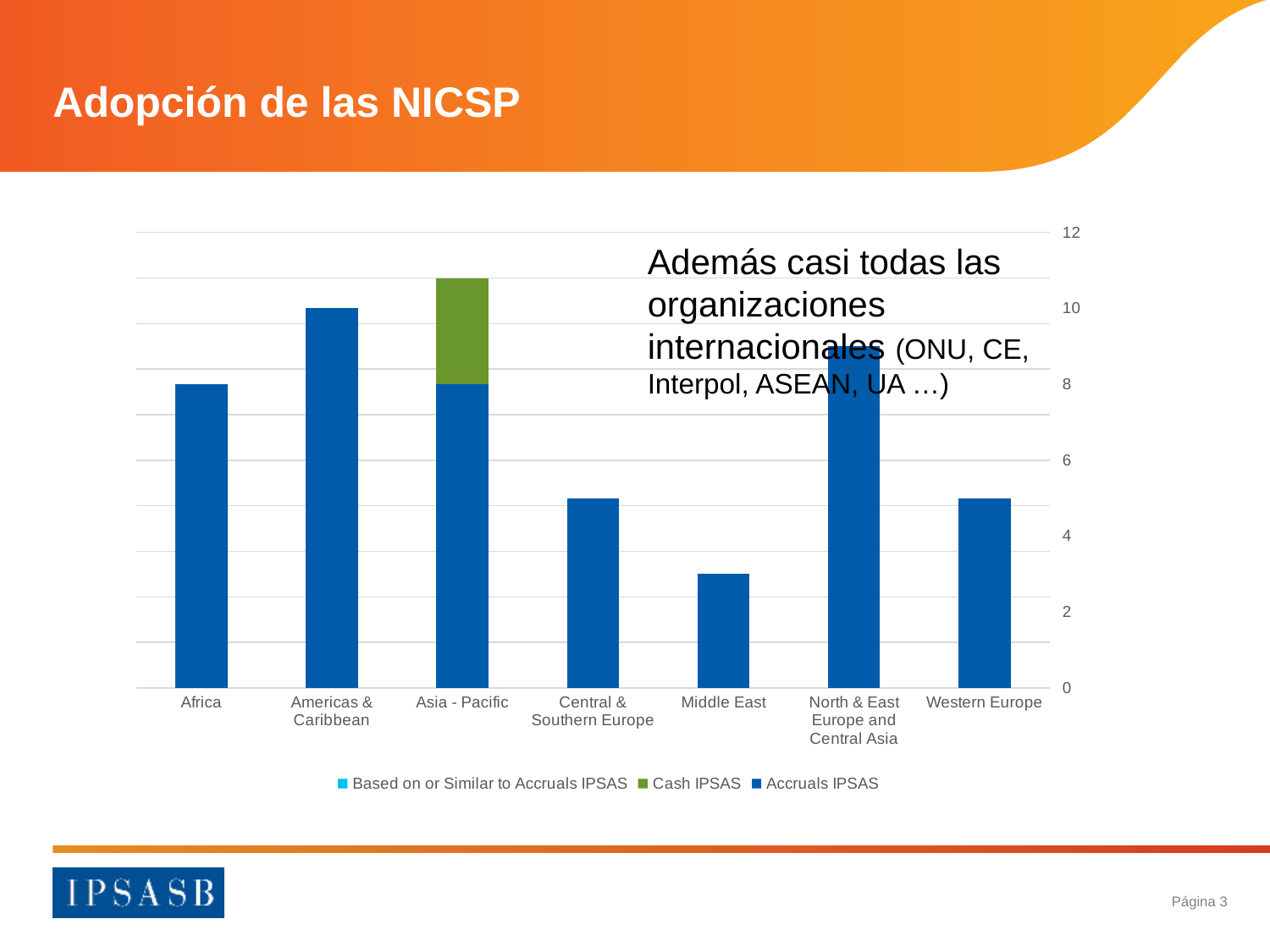
What is the value of the Accruals IPSAS bar for Americas & Caribbean? 10 Is the value for Western Europe greater or less than 6? less What is the value of the Accruals IPSAS bar for Africa? 8 Which category is the only one with a Cash IPSAS segment in its bar? Asia - Pacific How many series does the chart legend list? 3 Which category has the lowest bar in the chart? Middle East Is the value for Middle East greater or less than 4? less How many categories are shown on the x axis of the chart? 7 Which category has the tallest stacked bar in the chart? Asia - Pacific What kind of chart is shown on the slide? bar chart Which is larger, the bar for Americas & Caribbean or the bar for Africa? Americas & Caribbean What colour represents the Cash IPSAS series in the legend? green